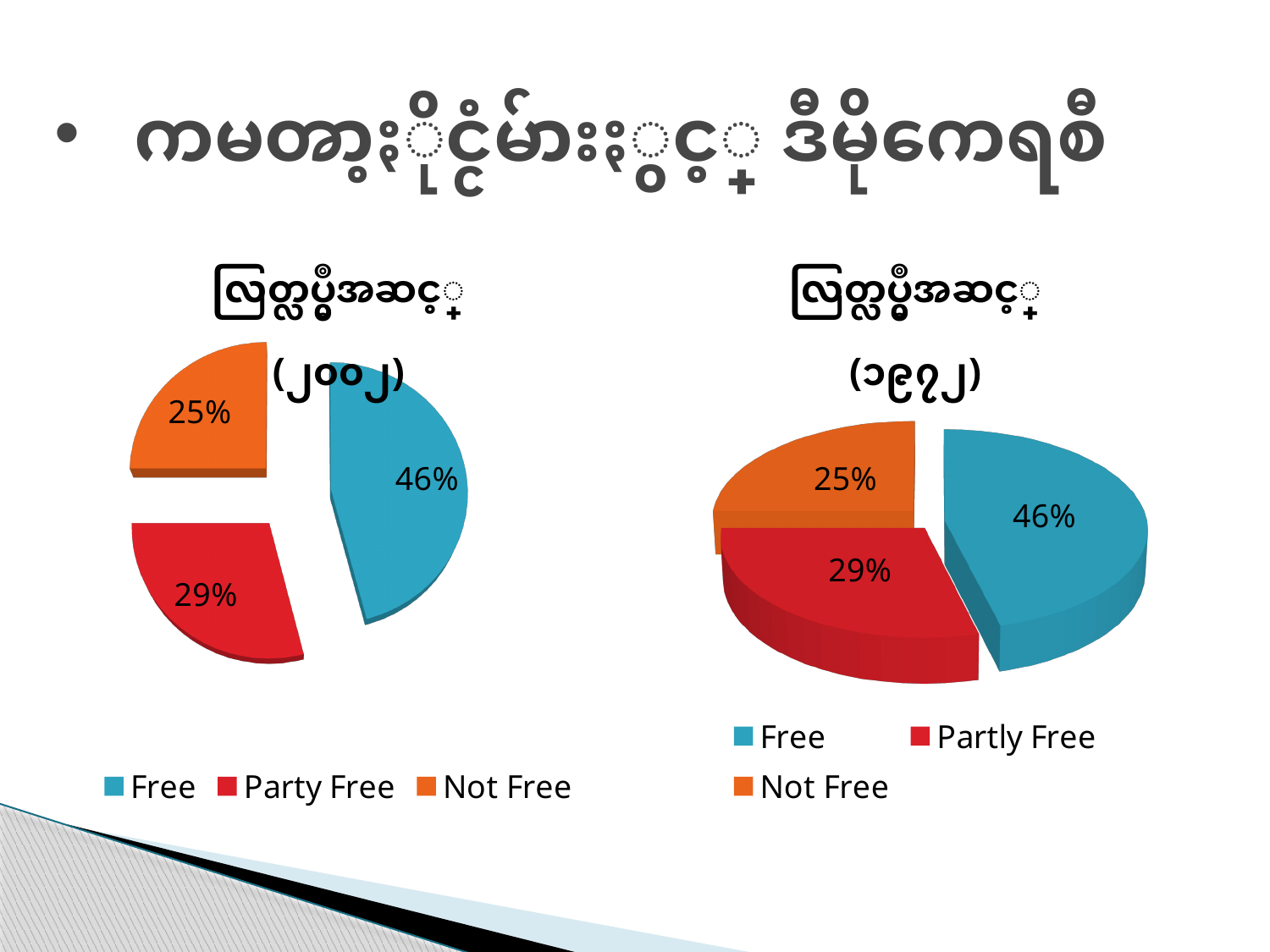
In the pie chart on the right, what is the difference in percentage points between the Free slice and the Not Free slice? 21 In the pie chart on the right, what share is labelled for the Partly Free slice? 29% In the pie chart on the left, what share is labelled for the Party Free slice? 29% In the pie chart on the left, what share is labelled for the Free slice? 46% What kind of chart is the chart on the left of the slide? pie chart In the pie chart on the left, which category has the smallest slice? Not Free In the pie chart on the right, which category has the largest slice? Free In the pie chart on the right, what share is labelled for the Free slice? 46% In the pie chart on the left, which is larger, the Party Free slice or the Not Free slice? Party Free How many slices does the pie chart on the right have? 3 In the pie chart on the left, what share is labelled for the Not Free slice? 25% How many entries does the legend of the pie chart on the left list? 3